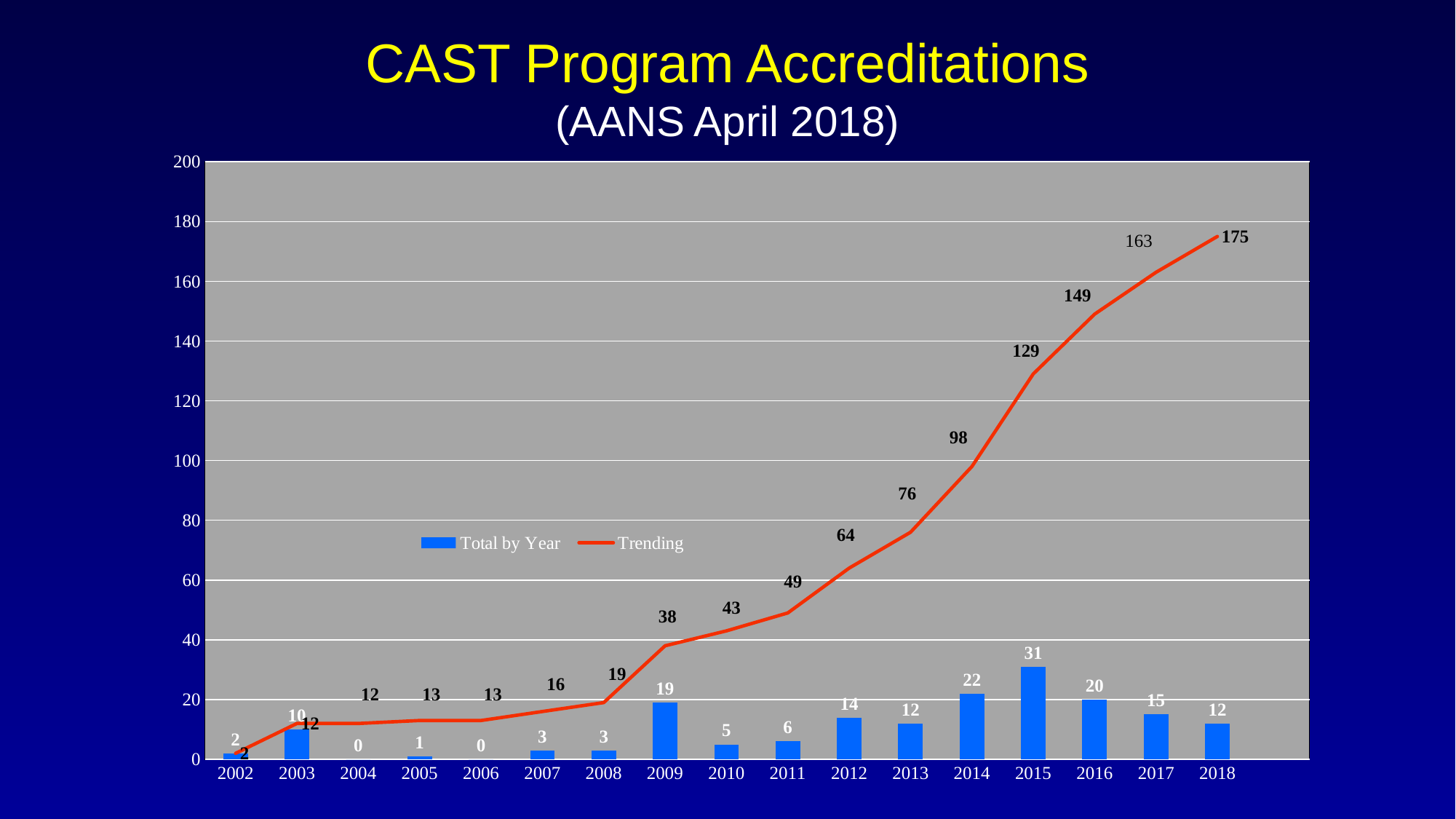
Which is larger, the Total by Year value for 2009 or for 2012? 2009 Which year has the lowest Trending value? 2002 Does the Trending line rise or fall from 2002 to 2018? rise What is the Total by Year value for 2015? 31 What is the Trending value for 2018? 175 What is the difference between the Total by Year values for 2015 and 2016? 11 What is the Trending value for 2014? 98 What is the difference between the Trending values for 2018 and 2017? 12 How many series does the legend list? 2 Which year has the highest Total by Year bar? 2015 How many years are shown on the x axis? 17 Is the Trending value for 2015 greater or less than 120? greater